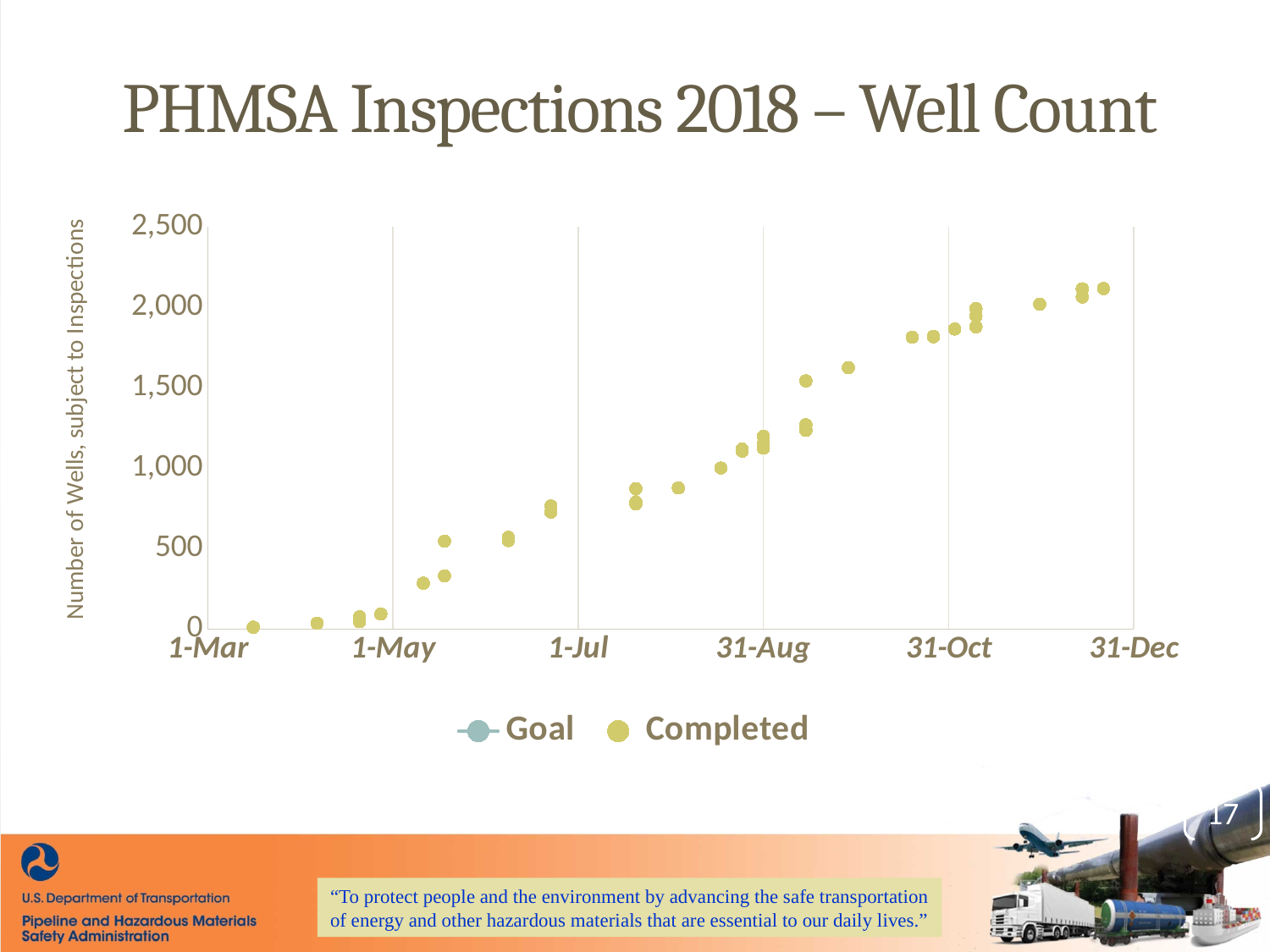
Is the Completed value at the last point near 31-Dec greater or less than 2,000? greater What is the title of the chart? PHMSA Inspections 2018 – Well Count Is the Completed value around 1-May greater or less than 500? less How many series does the legend list? 2 What kind of chart is shown on the slide? scatter chart Is the Completed value at the first point near 1-Mar greater or less than 500? less What are the two series named in the legend? Goal and Completed Do the Completed values rise or fall from 1-Mar to 31-Dec? rise Which is larger, the Completed value near 1-Mar or the Completed value near 31-Dec? 31-Dec Near which x-axis date does the highest Completed value occur? 31-Dec